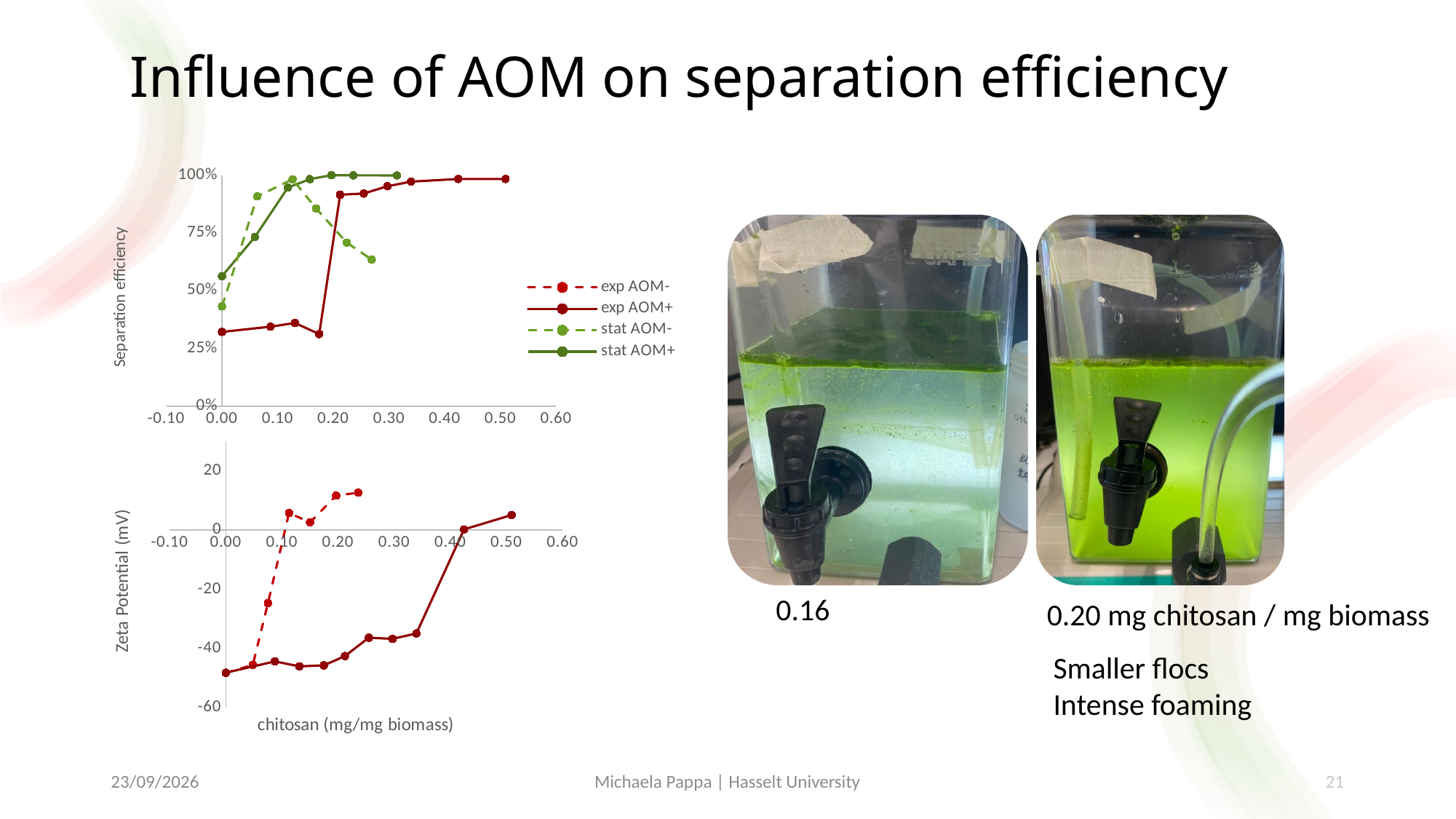
What is the x-axis label shown below the bottom chart? chitosan (mg/mg biomass) In the top chart, is the separation efficiency for exp AOM+ at 0.50 mg/mg biomass greater or less than 75%? greater How many series does the legend of the top chart list? 4 In the top chart, is the separation efficiency for exp AOM+ at 0.00 mg/mg biomass greater or less than 50%? less What is the y-axis label of the bottom chart? Zeta Potential (mV) In the top chart, is the separation efficiency for stat AOM+ at 0.20 mg/mg biomass greater or less than 75%? greater In the top chart, does the separation efficiency for exp AOM+ generally rise or fall as chitosan dose increases? rise What kind of chart is the top chart showing separation efficiency? line chart In the bottom chart, does the zeta potential for exp AOM+ rise or fall overall as chitosan dose increases from 0.00 to 0.50? rise